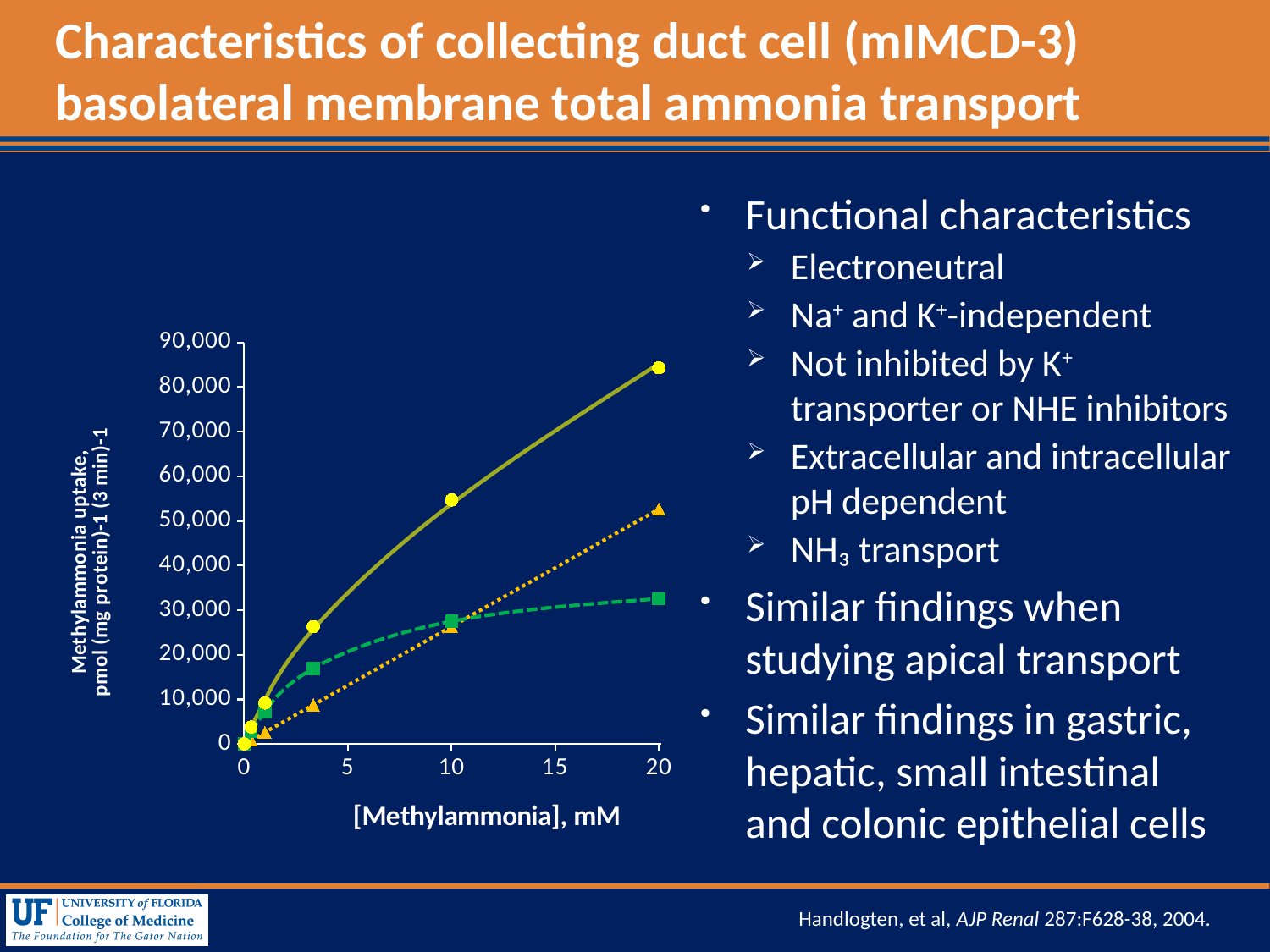
Is the value of the green-square series at 10 mM methylammonia greater or less than 30,000? less At 20 mM methylammonia, which is larger: the orange-triangle series or the green-square series? the orange-triangle series Is the value of the green-square series at 20 mM methylammonia greater or less than 40,000? less What is the title of the x axis of the chart? [Methylammonia], mM Which series has the lowest uptake value at 20 mM methylammonia? the green-square series Does methylammonia uptake for the yellow-circle series rise or fall as methylammonia concentration increases? rise Is the value of the orange-triangle series at 20 mM methylammonia greater or less than 50,000? greater What kind of chart is shown on the slide? line chart How many data series are plotted on the chart? 4